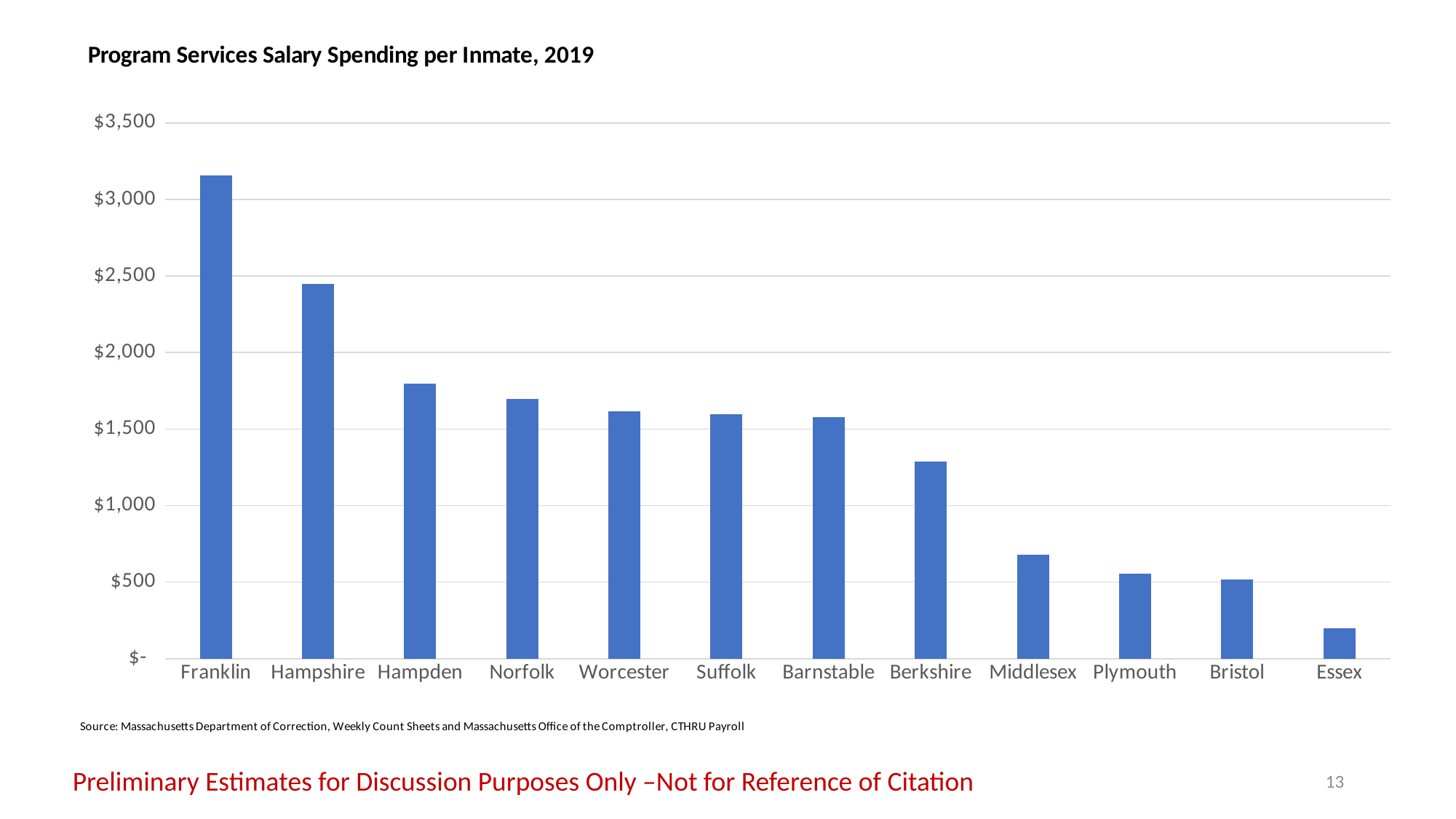
Which county has a higher value, Hampden or Plymouth? Hampden What kind of chart is shown on the slide? bar chart Which county has the highest program services salary spending per inmate? Franklin Is the value for Essex greater or less than $500? less Do the values rise or fall moving from left to right along the x axis? fall Is the value for Hampshire greater or less than $2,500? less Is the value for Middlesex greater or less than $1,000? less What is the title of the chart? Program Services Salary Spending per Inmate, 2019 How many counties are shown on the x axis? 12 Which county has the lowest program services salary spending per inmate? Essex